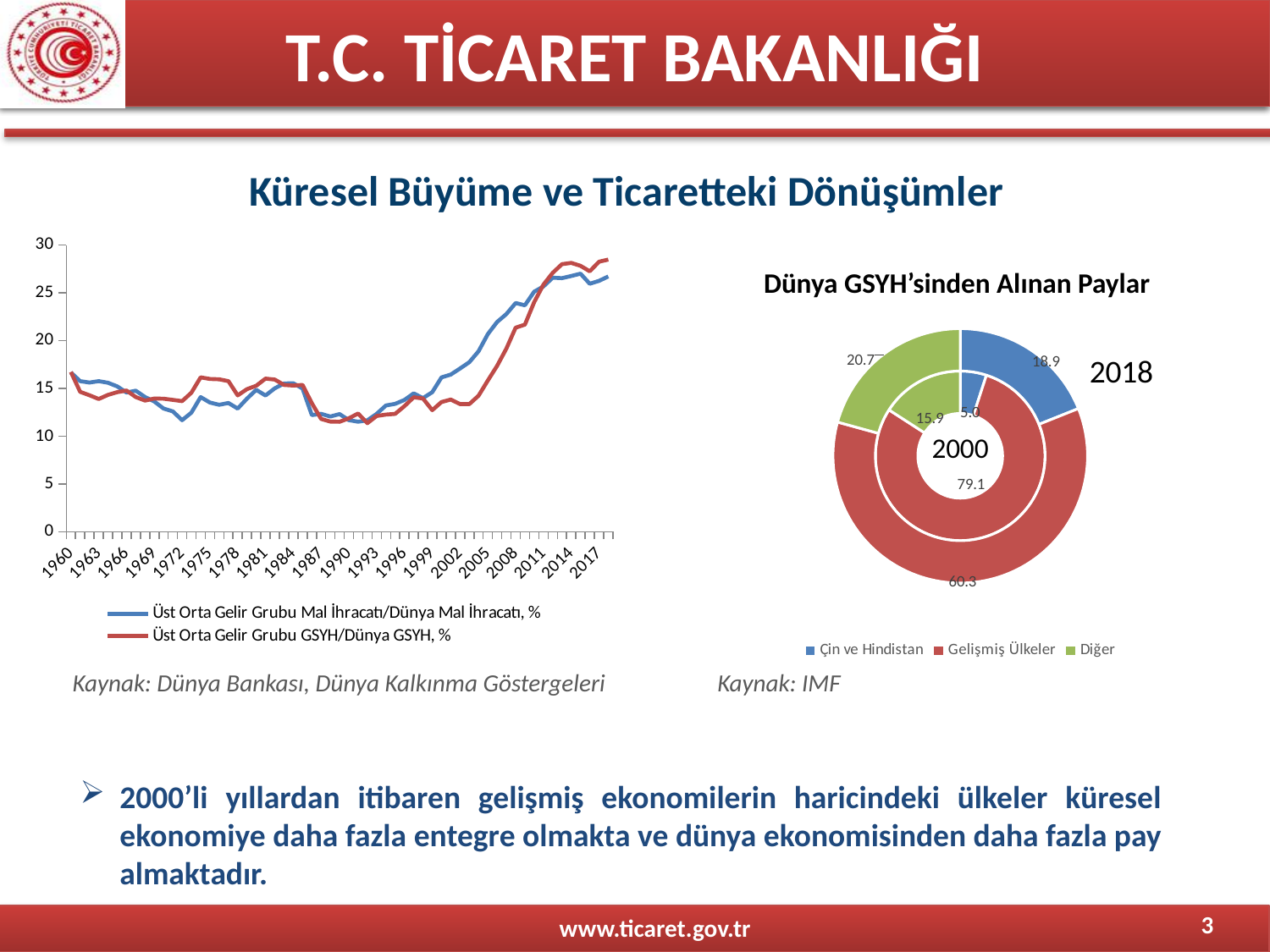
How many series does the legend of the left line chart list? 2 In the chart "Dünya GSYH'sinden Alınan Paylar", what is the 2000 share for Çin ve Hindistan? 5.0 In the chart "Dünya GSYH'sinden Alınan Paylar", what is the 2018 share for Diğer? 20.7 In the chart "Dünya GSYH'sinden Alınan Paylar", by how much did the share of Çin ve Hindistan change from 2000 to 2018? 13.9 In the chart "Dünya GSYH'sinden Alınan Paylar", is the 2000 share of Diğer larger or smaller than the 2018 share of Diğer? smaller In the chart "Dünya GSYH'sinden Alınan Paylar", which category has the smallest share in 2018? Çin ve Hindistan In the chart "Dünya GSYH'sinden Alınan Paylar", which category has the largest share in 2000? Gelişmiş Ülkeler What kind of chart is the chart titled "Dünya GSYH'sinden Alınan Paylar"? doughnut chart In the left line chart, is the value of Üst Orta Gelir Grubu Mal İhracatı/Dünya Mal İhracatı, % in 1972 greater or less than 15? less What kind of chart is the chart on the left of the slide? line chart In the left line chart, is the value of Üst Orta Gelir Grubu GSYH/Dünya GSYH, % in 2017 greater or less than 25? greater In the chart "Dünya GSYH'sinden Alınan Paylar", what is the 2018 share for Gelişmiş Ülkeler? 60.3